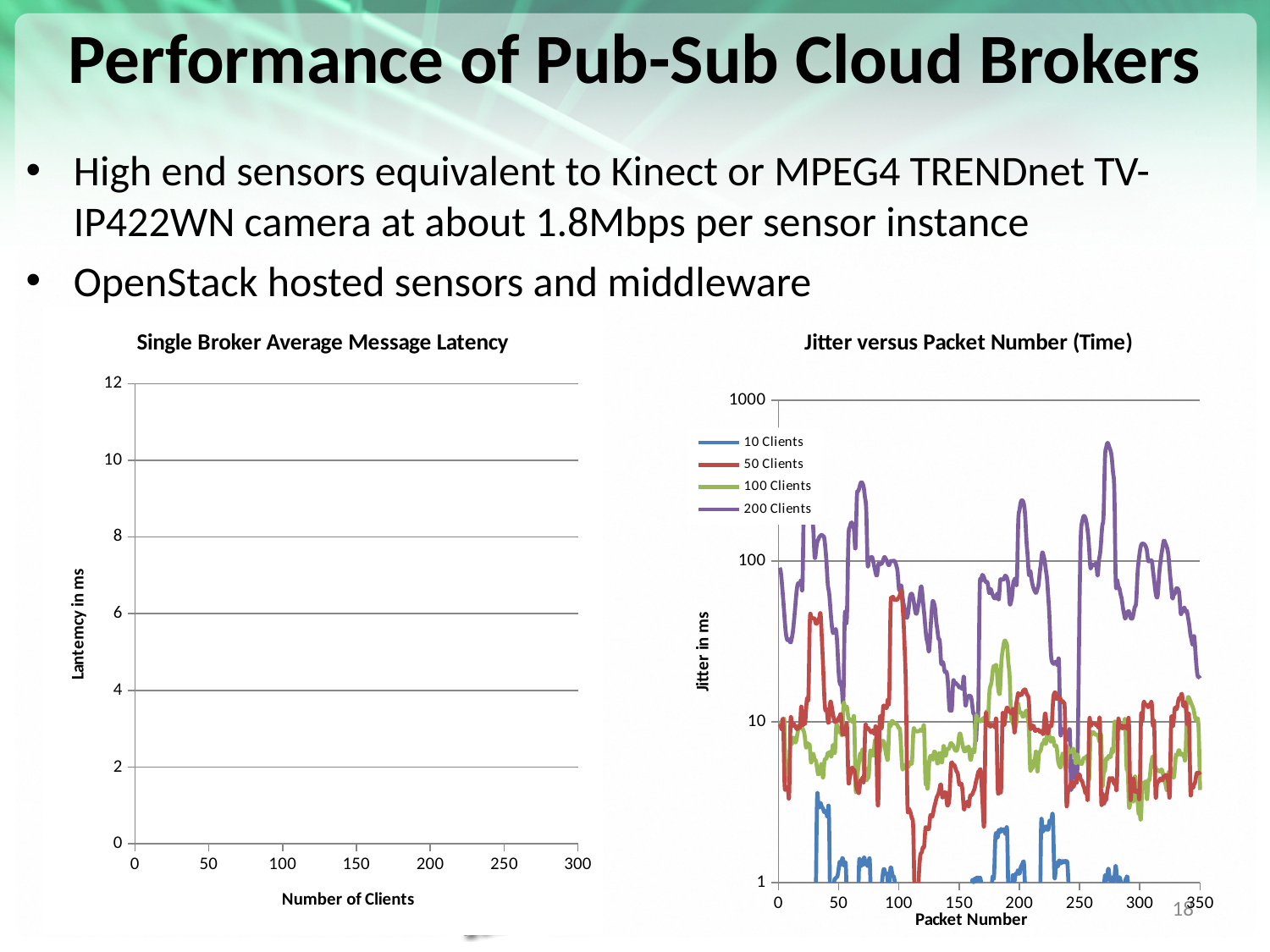
What is the y-axis title of the 'Jitter versus Packet Number (Time)' chart? Jitter in ms What is the highest value shown on the y-axis of the 'Jitter versus Packet Number (Time)' chart? 1000 In the 'Jitter versus Packet Number (Time)' chart, which series has higher jitter around packet number 275: 200 Clients or 100 Clients? 200 Clients In the 'Jitter versus Packet Number (Time)' chart, which series has the lowest jitter values over most of the packet range? 10 Clients In the 'Jitter versus Packet Number (Time)' chart, is the peak jitter for 200 Clients near packet number 275 greater or less than 100 ms? greater In the 'Jitter versus Packet Number (Time)' chart, which series does the legend list first? 10 Clients In the 'Jitter versus Packet Number (Time)' chart, is the jitter for 10 Clients greater or less than 10 ms across the packet range? less In the 'Jitter versus Packet Number (Time)' chart, which series has the highest jitter values over most of the packet range? 200 Clients What kind of chart is the 'Jitter versus Packet Number (Time)' chart? line chart How many series does the legend of the 'Jitter versus Packet Number (Time)' chart list? 4